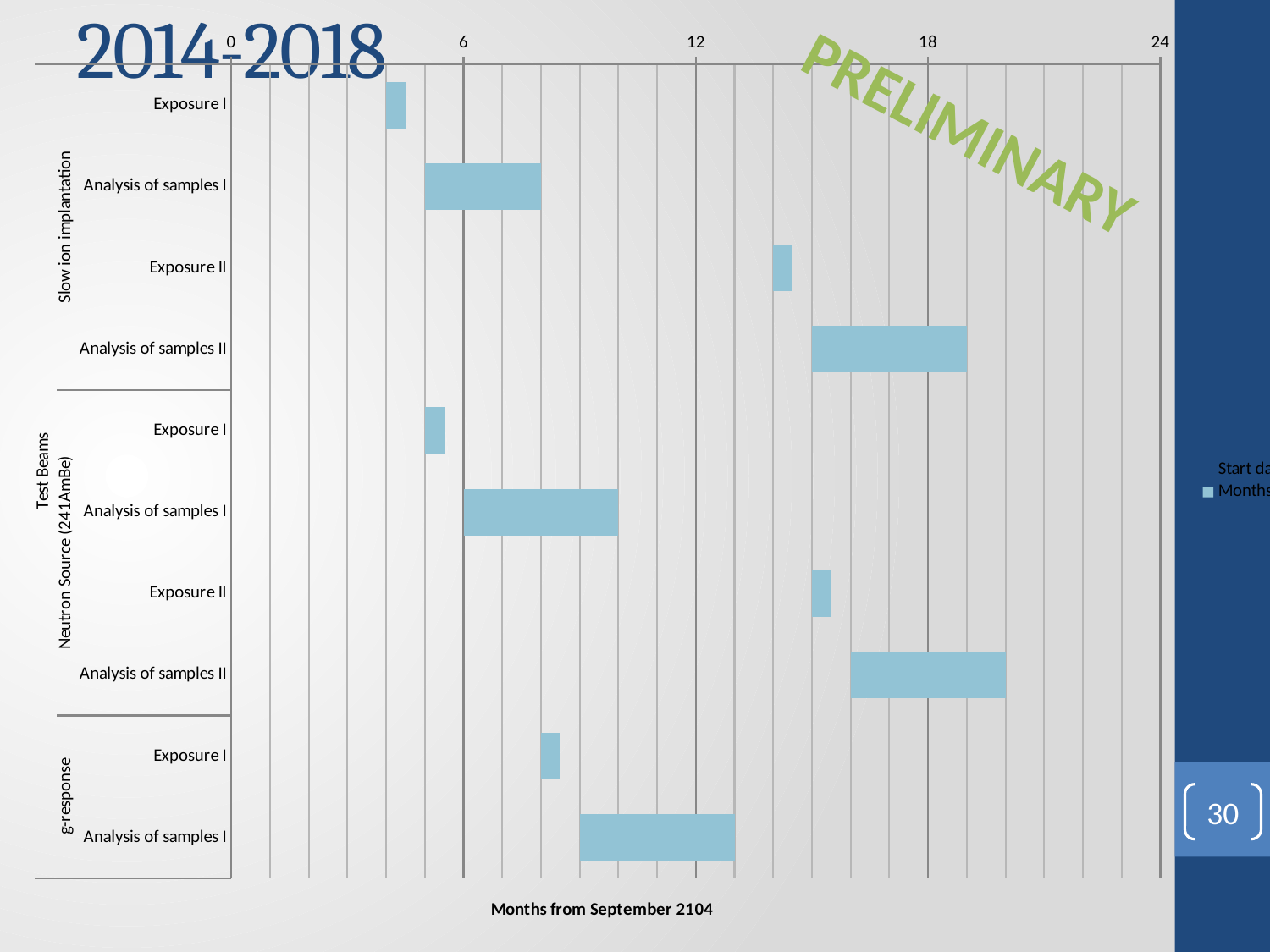
What is the title of the horizontal axis of the chart? Months from September 2104 What is the highest value labelled on the horizontal axis of the chart? 24 Is the start of the bar for Analysis of samples II under Slow ion implantation greater or less than 12? greater Which bar starts later: Exposure II under Slow ion implantation or Exposure II under Neutron Source (241AmBe)? Exposure II under Neutron Source (241AmBe) Is the start of the bar for Exposure II under Slow ion implantation greater or less than 12? greater Which task's bar starts earliest on the chart? Exposure I (Slow ion implantation) Is the end of the bar for Analysis of samples I under Neutron Source (241AmBe) greater or less than 12? less Which task's bar extends furthest to the right on the chart? Analysis of samples II (Neutron Source (241AmBe)) How many task categories are listed on the vertical axis of the chart? 10 What kind of chart is shown on the slide? bar chart